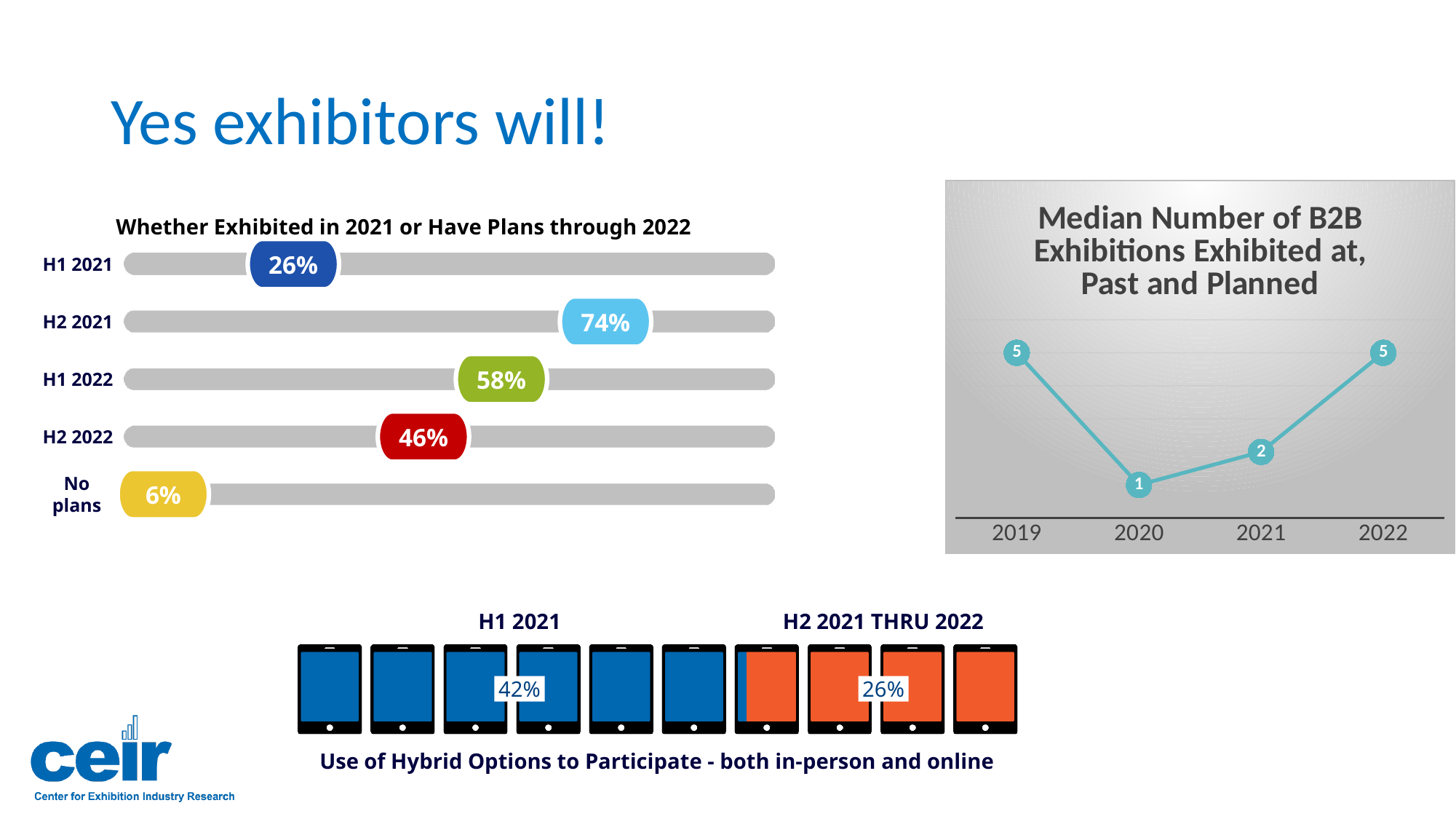
In the chart 'Median Number of B2B Exhibitions Exhibited at, Past and Planned', what is the value for 2021? 2 In the chart 'Whether Exhibited in 2021 or Have Plans through 2022', how many categories are shown? 5 In the chart 'Whether Exhibited in 2021 or Have Plans through 2022', what is the value for H2 2021? 74% In the chart 'Median Number of B2B Exhibitions Exhibited at, Past and Planned', do the values rise or fall from 2020 to 2022? Rise What kind of chart is 'Median Number of B2B Exhibitions Exhibited at, Past and Planned'? Line chart In the chart 'Whether Exhibited in 2021 or Have Plans through 2022', what is the value for H1 2022? 58% In the chart 'Whether Exhibited in 2021 or Have Plans through 2022', which category has the highest value? H2 2021 In the chart 'Median Number of B2B Exhibitions Exhibited at, Past and Planned', what is the value for 2020? 1 In the chart 'Whether Exhibited in 2021 or Have Plans through 2022', what is the difference between the H2 2021 and H1 2021 values? 48% What kind of chart is 'Whether Exhibited in 2021 or Have Plans through 2022'? Bar chart In the chart 'Use of Hybrid Options to Participate - both in-person and online' at the bottom of the slide, what is the value for H2 2021 THRU 2022? 26% In the chart 'Whether Exhibited in 2021 or Have Plans through 2022', which category has the lowest value? No plans